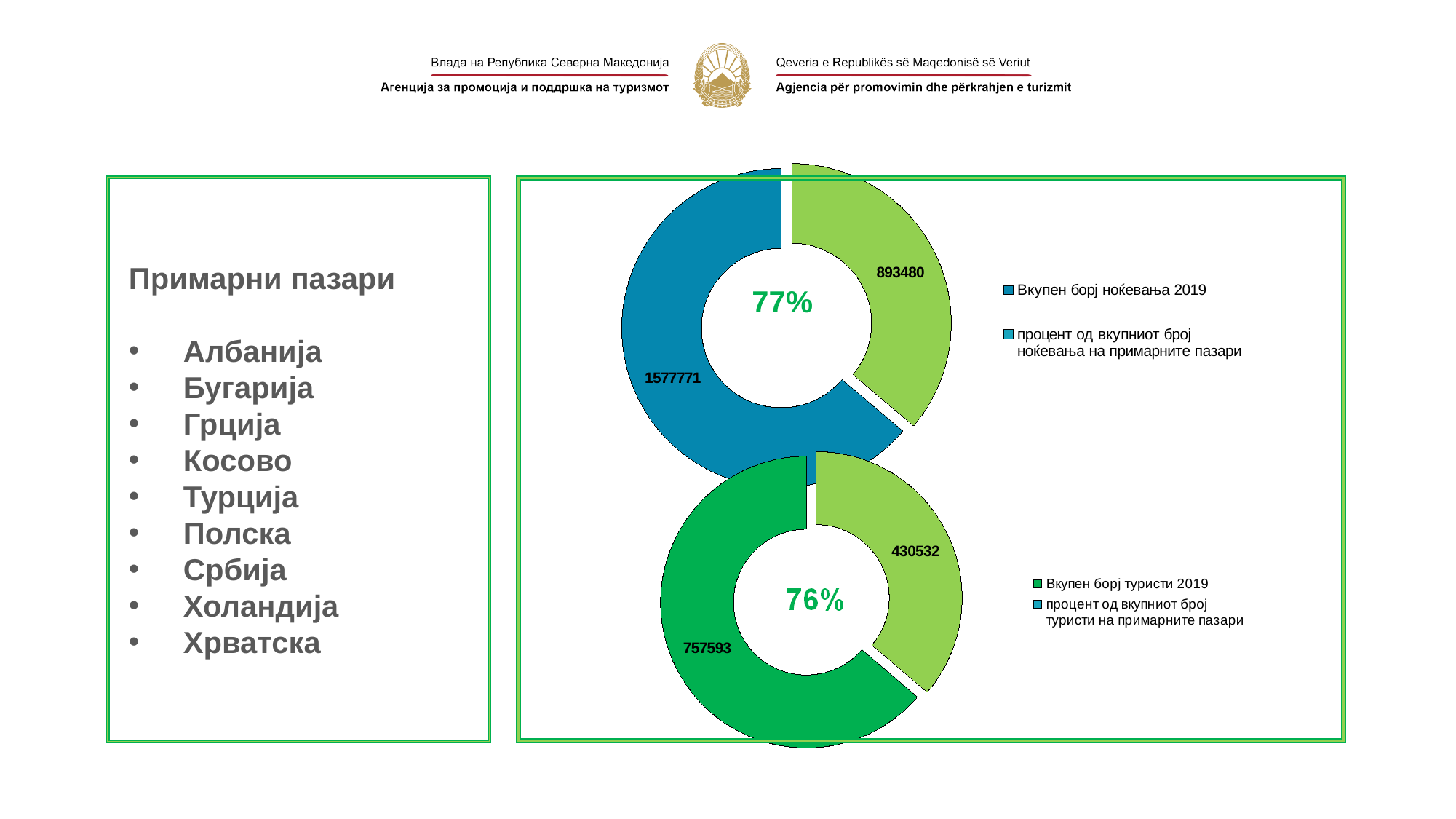
What percentage is shown in the centre of the top doughnut chart? 77% What percentage is shown in the centre of the bottom doughnut chart? 76% Which chart shows the higher centre percentage, the top doughnut chart or the bottom doughnut chart? the top doughnut chart How many entries does the legend of the top doughnut chart list? 2 In the top doughnut chart, what value is printed on the blue slice? 1577771 In the bottom doughnut chart, what value is printed on the light green slice? 430532 What kind of chart is shown at the top of the right panel? doughnut chart In the top doughnut chart, what is the difference between the two printed values, 1577771 and 893480? 684291 How many slices does the bottom doughnut chart have? 2 In the bottom doughnut chart, what is the difference between the two printed values, 757593 and 430532? 327061 In the top doughnut chart, what value is printed on the green slice? 893480 In the bottom doughnut chart, what value is printed on the dark green slice? 757593